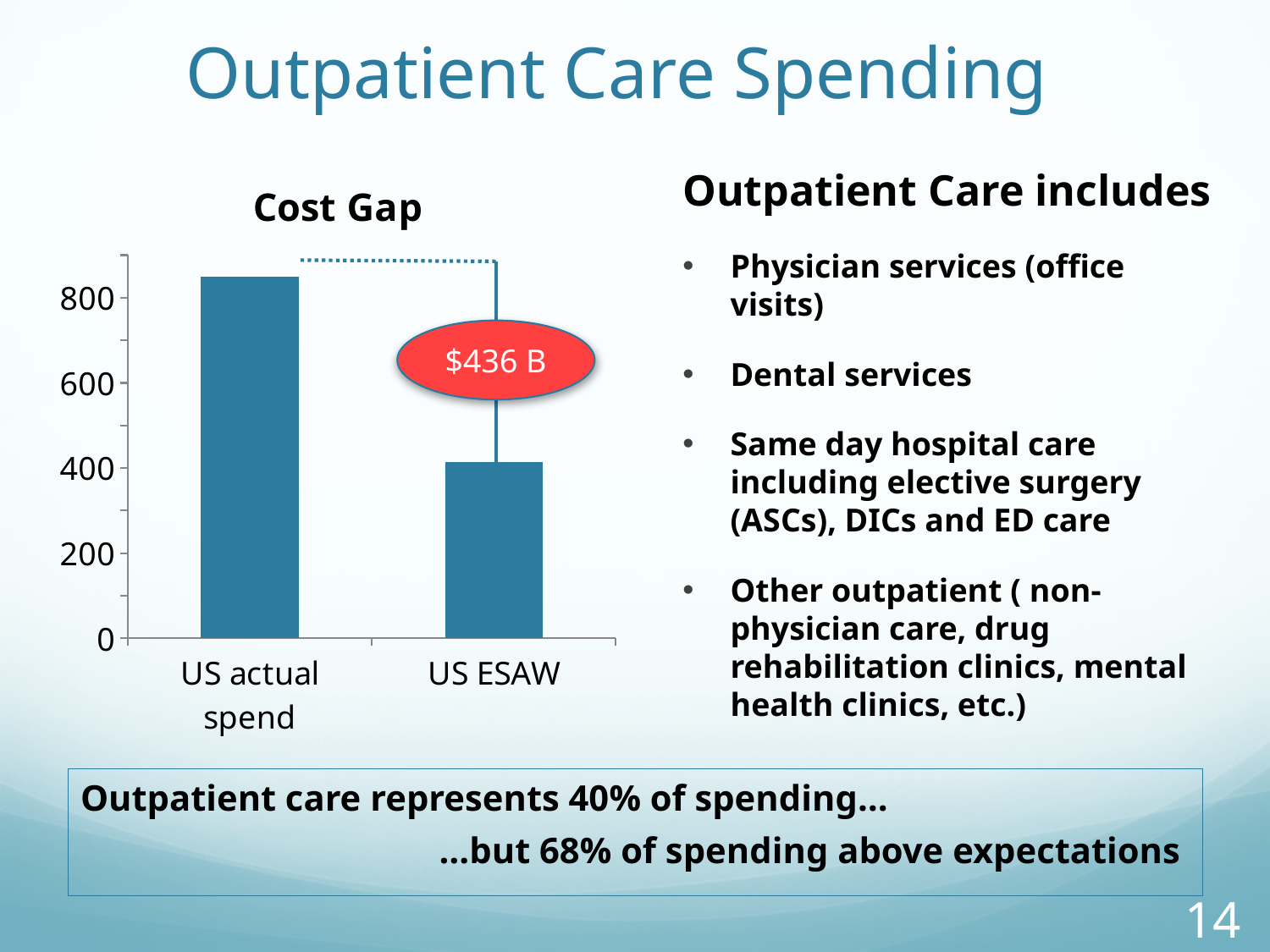
How many bars are plotted in the Cost Gap chart? 2 Which category has the lowest bar in the Cost Gap chart? US ESAW Do the bar values rise or fall from left to right in the Cost Gap chart? fall Is the value for US ESAW greater or less than 200? greater Which is larger, US actual spend or US ESAW? US actual spend What is the highest value shown on the vertical axis of the Cost Gap chart? 800 Is the value for US actual spend greater or less than 800? greater What gap amount is labelled between the two bars in the Cost Gap chart? $436 B Which category has the highest bar in the Cost Gap chart? US actual spend Is the value for US ESAW greater or less than 600? less What is the title of the chart? Cost Gap What type of chart is shown on the slide? bar chart